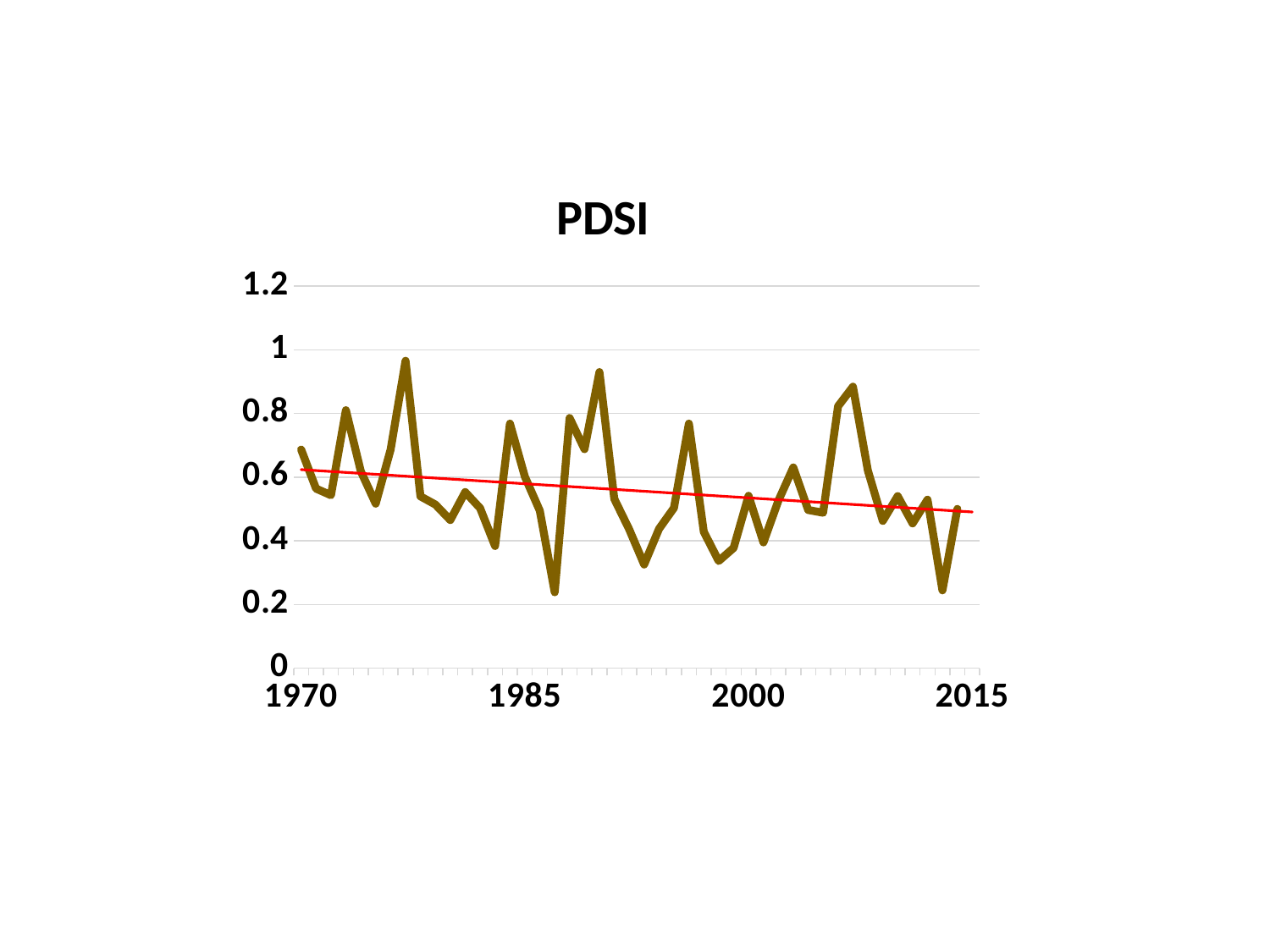
What kind of chart is shown on the slide? line chart Does the red trend line rise or fall from 1970 to 2015? fall Is the PDSI value for 1970 greater or less than 0.6? greater What is the title of the chart? PDSI Is the PDSI value for 1970 greater or less than 0.8? less What is the highest value labelled on the y axis? 1.2